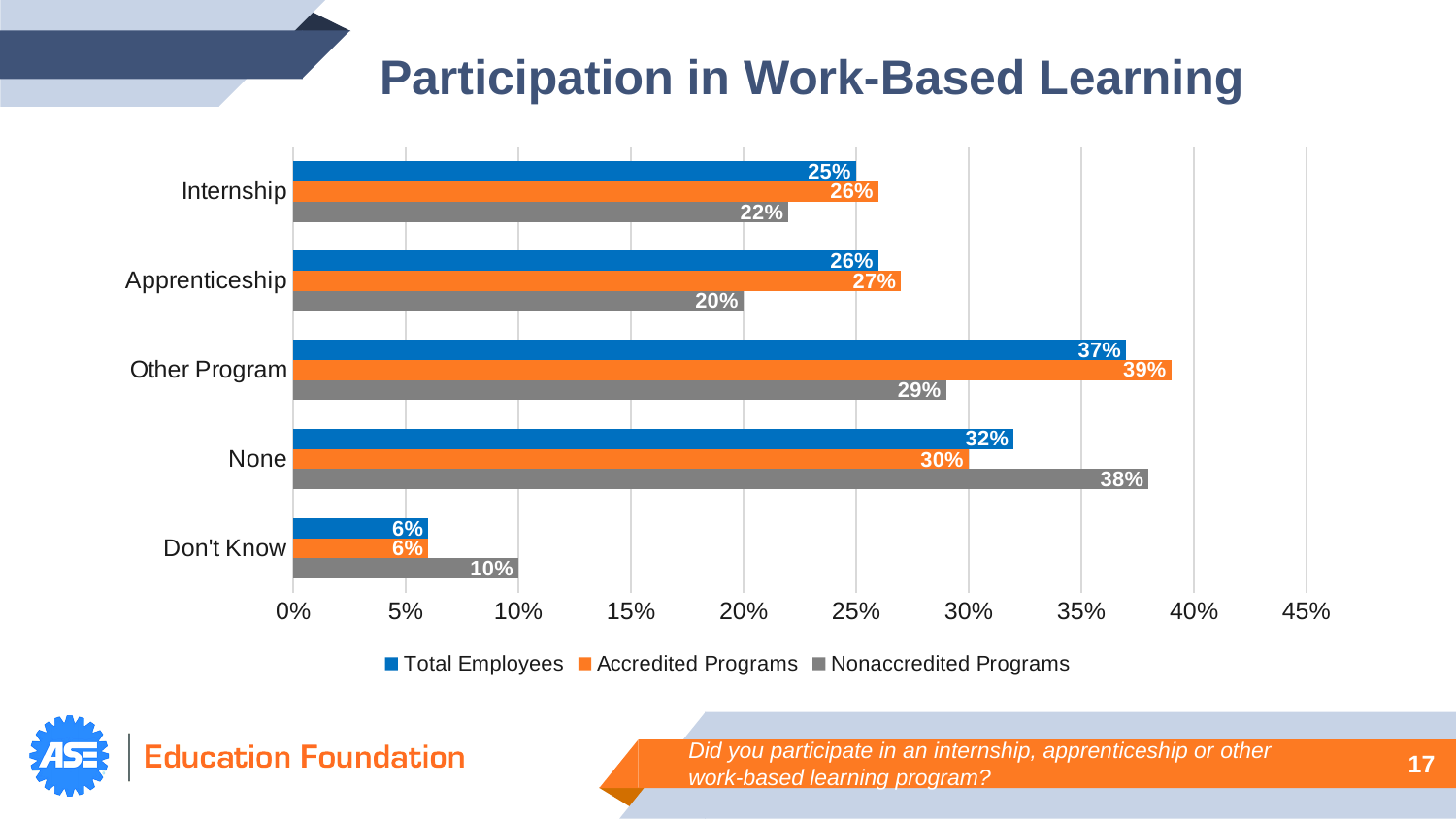
What is the difference between the Accredited Programs and Nonaccredited Programs values for Other Program? 10% What is the Accredited Programs value for Other Program? 39% Which category has the lowest Nonaccredited Programs value? Don't Know What is the Total Employees value for Apprenticeship? 26% What is the Nonaccredited Programs value for None? 38% How many categories are shown on the chart? 5 Which series is shown in orange? Accredited Programs For None, which is larger: the Total Employees value or the Nonaccredited Programs value? Nonaccredited Programs How many series does the legend list? 3 Which category has the highest Total Employees value? Other Program What is the title of the chart? Participation in Work-Based Learning What kind of chart is shown on the slide? Bar chart